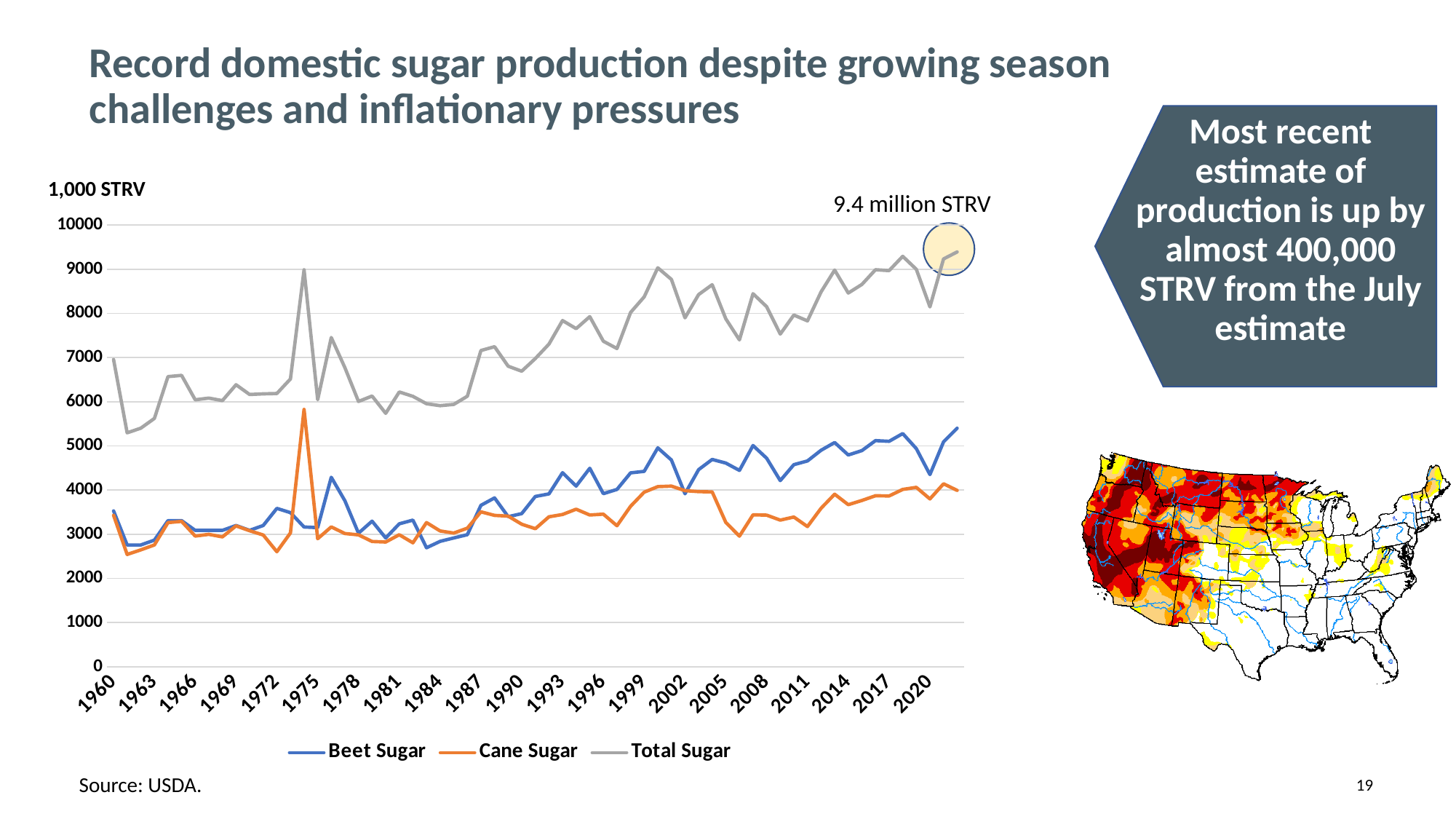
What unit is shown above the vertical axis of the chart? 1,000 STRV What value is annotated at the end of the Total Sugar line? 9.4 million STRV Which series has the highest values throughout the chart? Total Sugar Is the value for Beet Sugar in 2020 greater or less than 4000? greater Which series are listed in the chart legend? Beet Sugar, Cane Sugar, Total Sugar How many series does the chart legend list? 3 In 1975, which is larger: Cane Sugar or Beet Sugar? Beet Sugar What kind of chart is shown on the slide? Line chart In 2017, which is larger: Beet Sugar or Cane Sugar? Beet Sugar Does the Beet Sugar line generally rise or fall from 1984 to the end of the chart? Rise